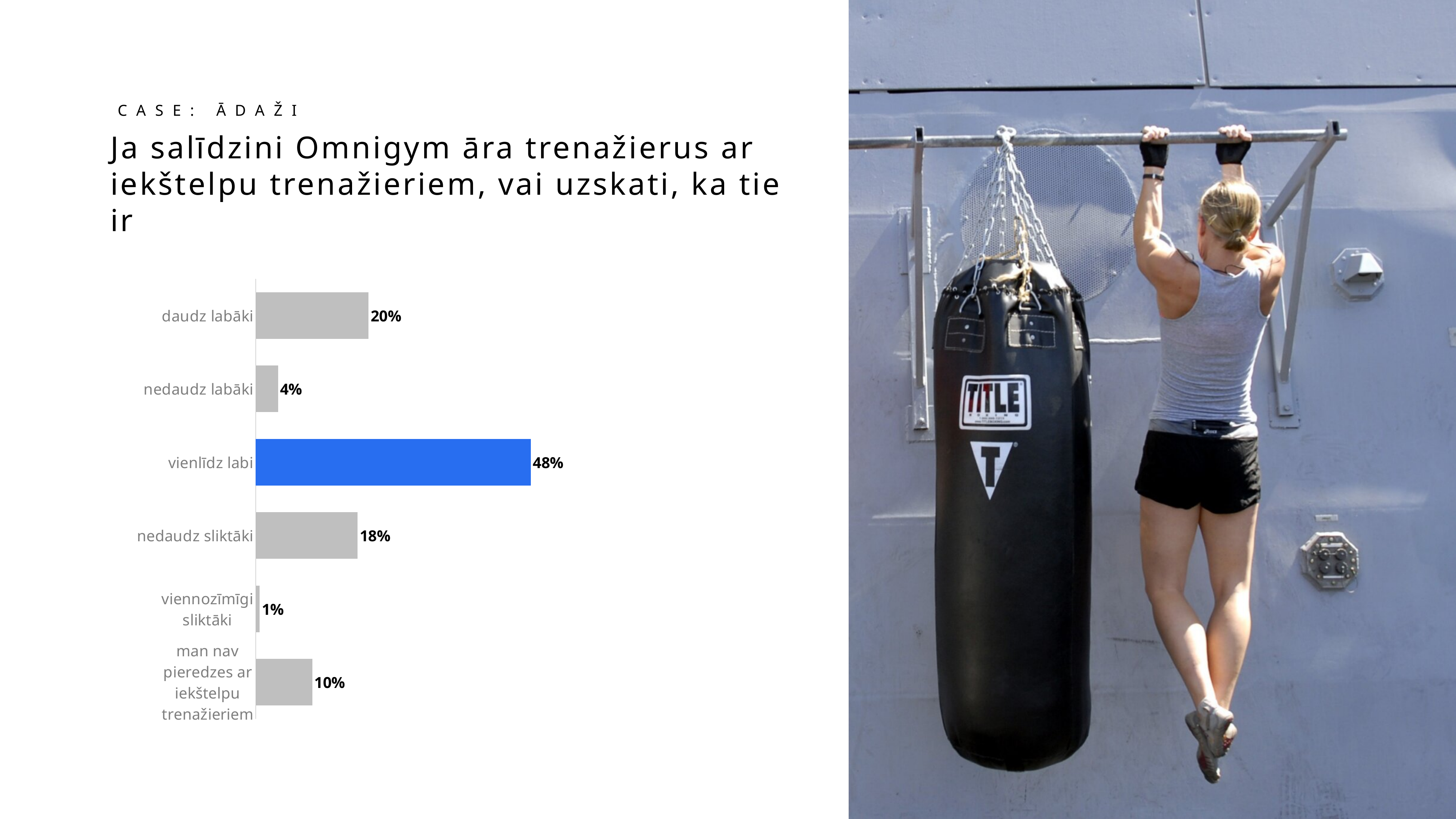
What is the value for "vienlīdz labi"? 48% What is the difference between the values for "vienlīdz labi" and "daudz labāki"? 28% Which bar is highlighted in blue? vienlīdz labi How many categories are shown in the chart? 6 What is the value for "nedaudz sliktāki"? 18% What is the value for "man nav pieredzes ar iekštelpu trenažieriem"? 10% What is the difference between the values for "nedaudz sliktāki" and "nedaudz labāki"? 14% Which category has the lowest value? viennozīmīgi sliktāki Which category has the highest value? vienlīdz labi What is the value for "daudz labāki"? 20% What kind of chart is shown on the slide? bar chart Which is larger, the value for "daudz labāki" or the value for "nedaudz sliktāki"? daudz labāki